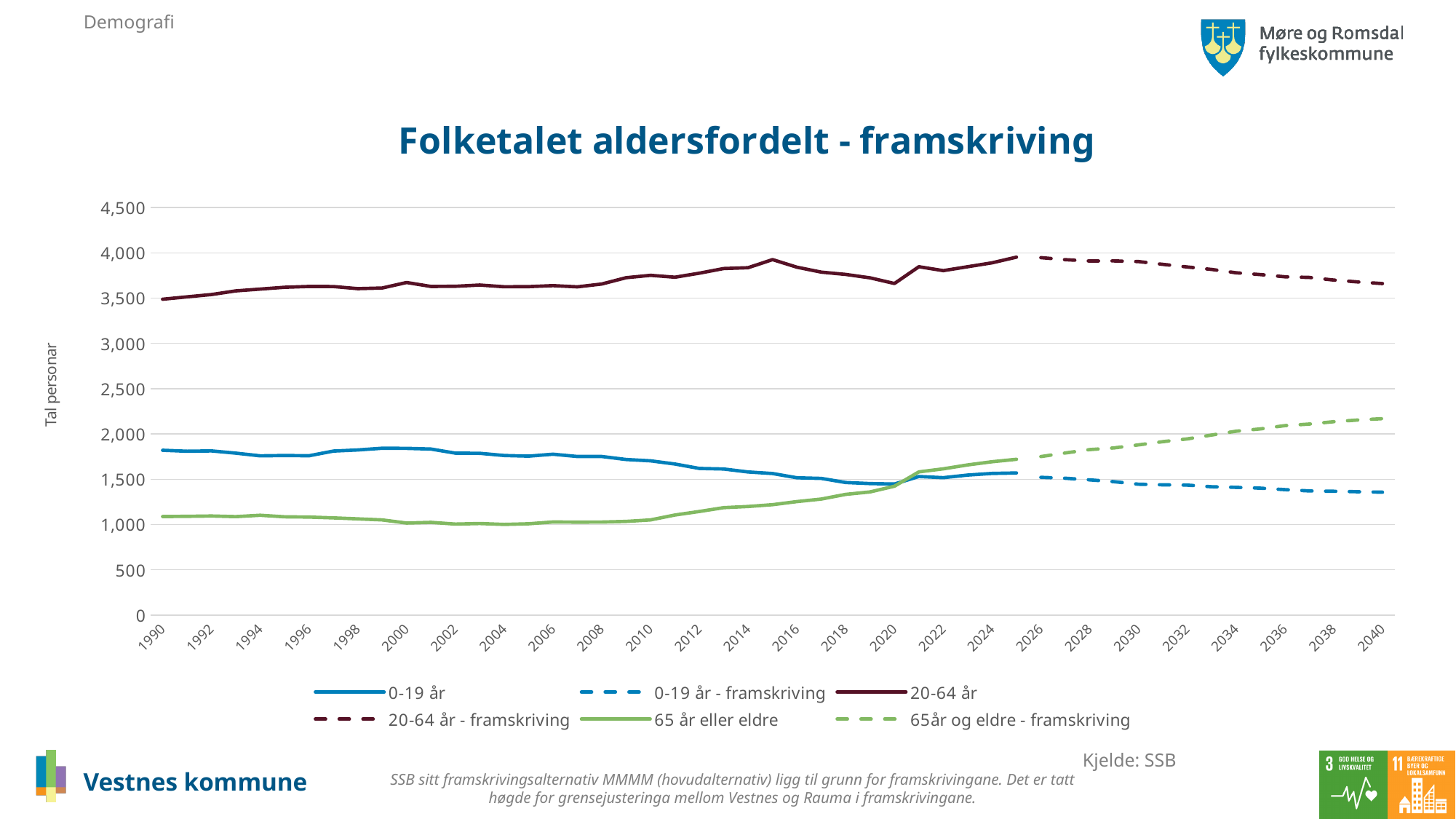
What is the label on the vertical axis of the chart? Tal personar Is the value for 65 år eller eldre in 2004 greater or less than 1,500? less What is the title of the chart? Folketalet aldersfordelt - framskriving Is the value for 0-19 år in 2000 greater or less than 1,500? greater Which series has the highest values across the whole chart? 20-64 år In 2040, which is higher: 65år og eldre - framskriving or 0-19 år - framskriving? 65år og eldre - framskriving Is the value for 65år og eldre - framskriving in 2040 greater or less than 2,000? greater What kind of chart is shown on the slide? line chart Does the 65 år eller eldre series rise or fall between 2010 and 2024? rises Does the 0-19 år - framskriving series rise or fall between 2026 and 2040? falls How many series does the legend list? 6